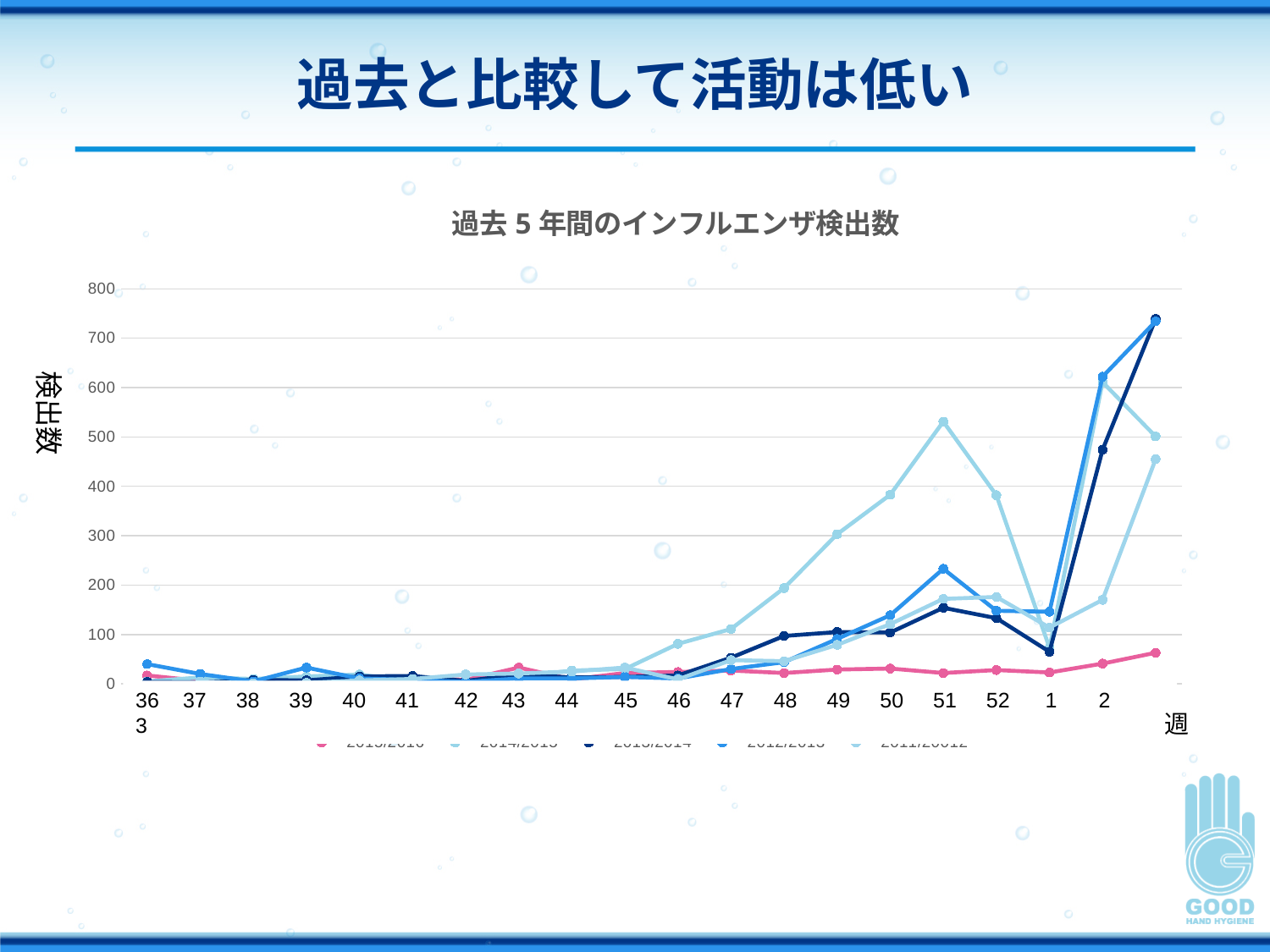
Which line stays lowest across the chart, the pink line or the dark navy line? pink line What is the label of the vertical axis? 検出数 Is the highest value at week 2 greater or less than 600? greater Is the highest value at week 45 greater or less than 100? less Is the highest value reached by any line on the chart greater or less than 700? greater What is the title of the chart? 過去 5 年間のインフルエンザ検出数 Do the values of the lines generally rise or fall from week 36 to the end of the x axis? rise How many series does the chart's legend list? 5 What kind of chart is shown on the slide? line chart